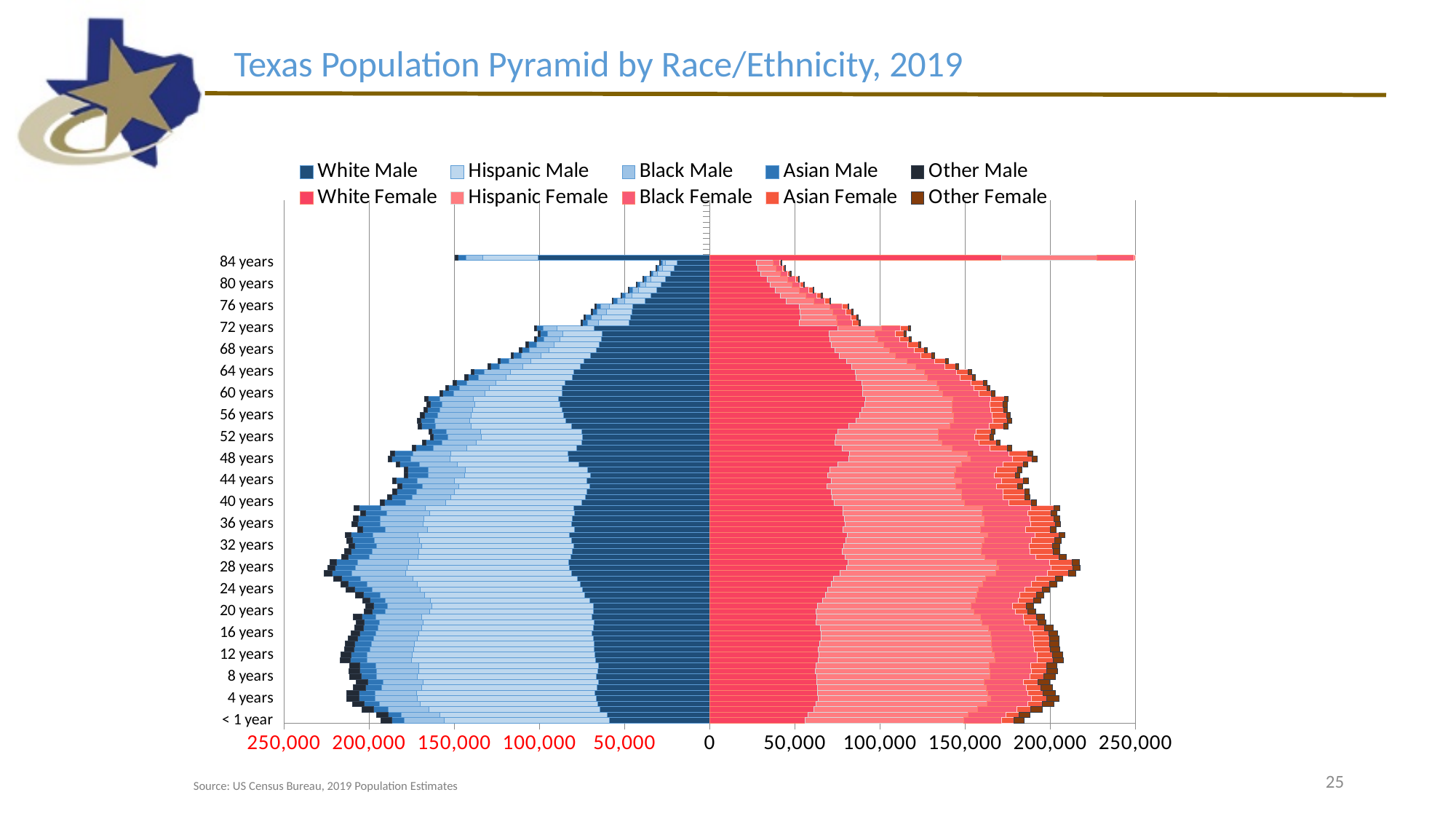
Is the total male value for 60 years greater or less than 150,000? greater What is the title of the chart? Texas Population Pyramid by Race/Ethnicity, 2019 Which legend entry is shown in dark navy blue? White Male Is the total female value for 60 years greater or less than 200,000? less How many series does the legend list? 10 Is the total male value for 80 years greater or less than 50,000? less Which has the larger total male bar, 28 years or 60 years? 28 years What kind of chart is shown on the slide? bar chart Which has the larger total male bar, 84 years or 80 years? 80 years